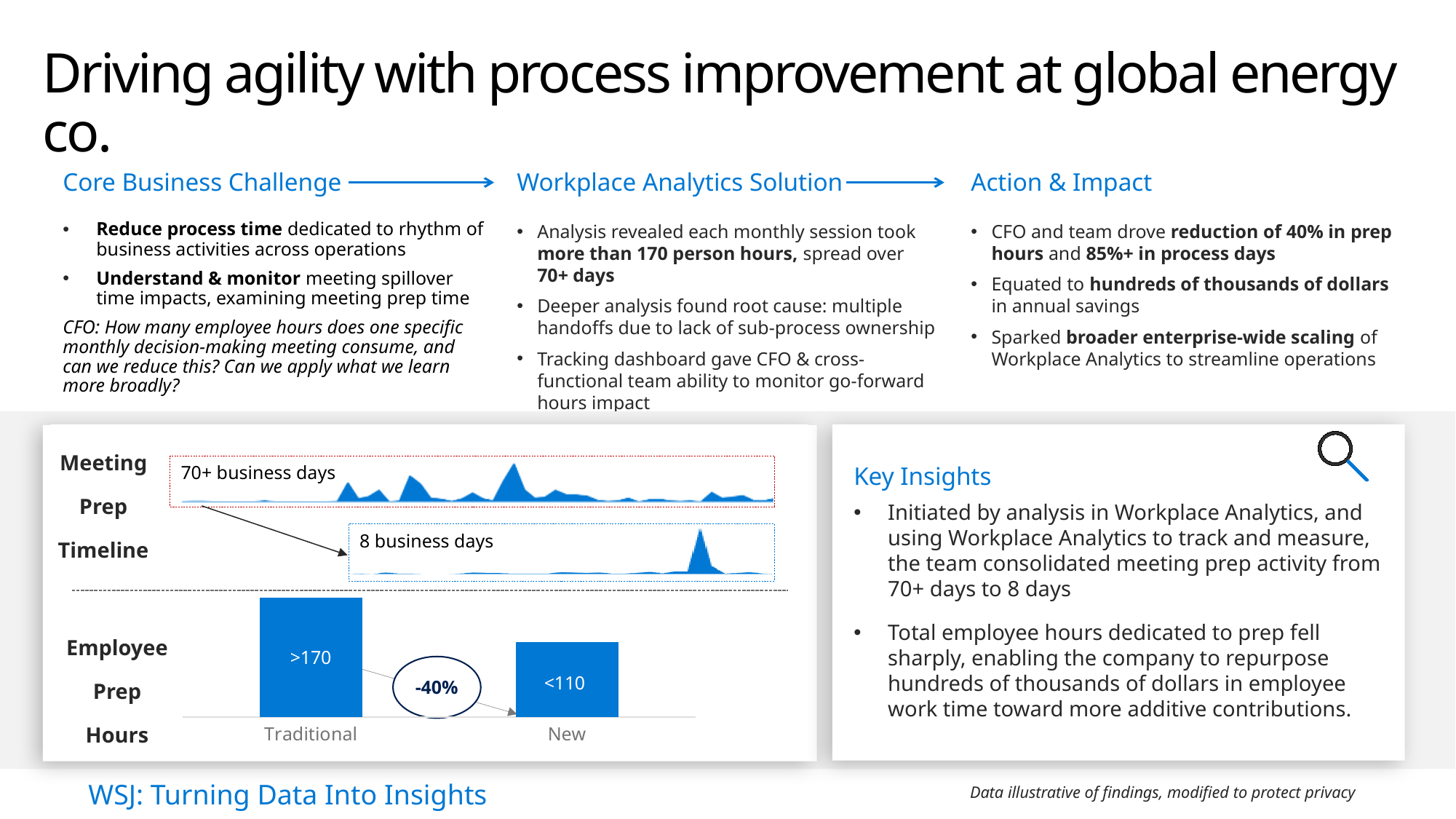
In the Employee Prep Hours chart, what is the data label on the New bar? <110 In the Employee Prep Hours chart, which category has the shorter bar? New How many bars are shown in the Employee Prep Hours chart? 2 In the Employee Prep Hours chart, what percentage change is shown in the circle between the Traditional and New bars? -40% In the Employee Prep Hours chart, is the Traditional bar larger or smaller than the New bar? larger In the Meeting Prep Timeline chart, how many business days does the lower (new) timeline span according to its label? 8 business days In the Employee Prep Hours chart, which category has the taller bar? Traditional What kind of chart is the Employee Prep Hours chart? bar chart In the Employee Prep Hours chart, what is the data label on the Traditional bar? >170 Do the values in the Employee Prep Hours chart rise or fall from Traditional to New? fall What are the two category labels on the x axis of the Employee Prep Hours chart? Traditional and New In the Meeting Prep Timeline chart, how many business days does the upper (traditional) timeline span according to its label? 70+ business days